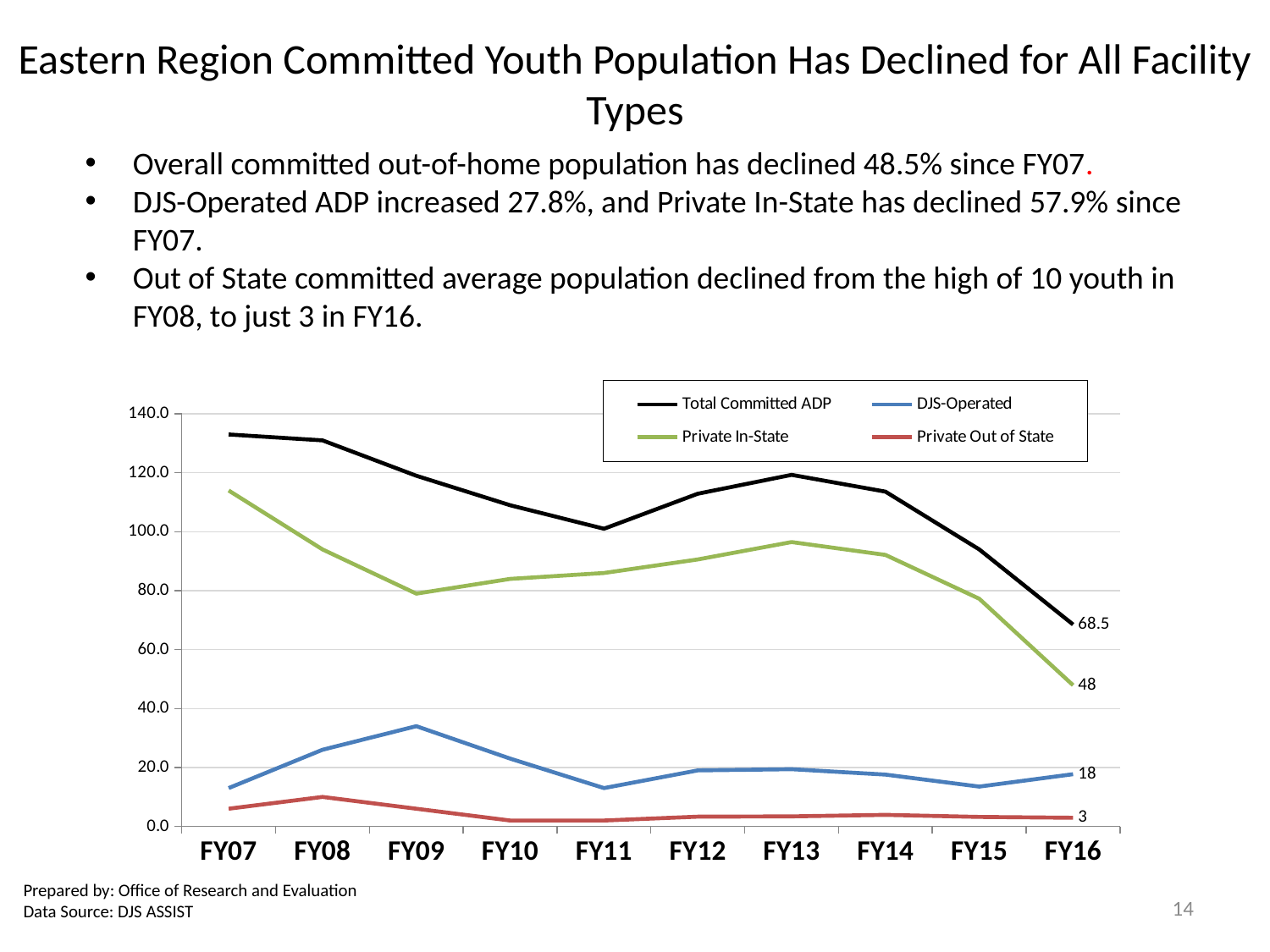
How many series does the legend list? 4 Which series has the lowest value in FY16? Private Out of State Is the value for Total Committed ADP in FY07 greater or less than 120? greater How many fiscal years are shown on the x axis? 10 What kind of chart is shown on the slide? line chart What is the value of DJS-Operated in FY16? 18 What is the value of Private In-State in FY16? 48 What is the difference between Total Committed ADP and Private In-State in FY16? 20.5 Is the value for DJS-Operated in FY11 greater or less than 20? less What is the value of Total Committed ADP in FY16? 68.5 What is the value of Private Out of State in FY16? 3 In which fiscal year does the DJS-Operated line reach its highest point? FY09